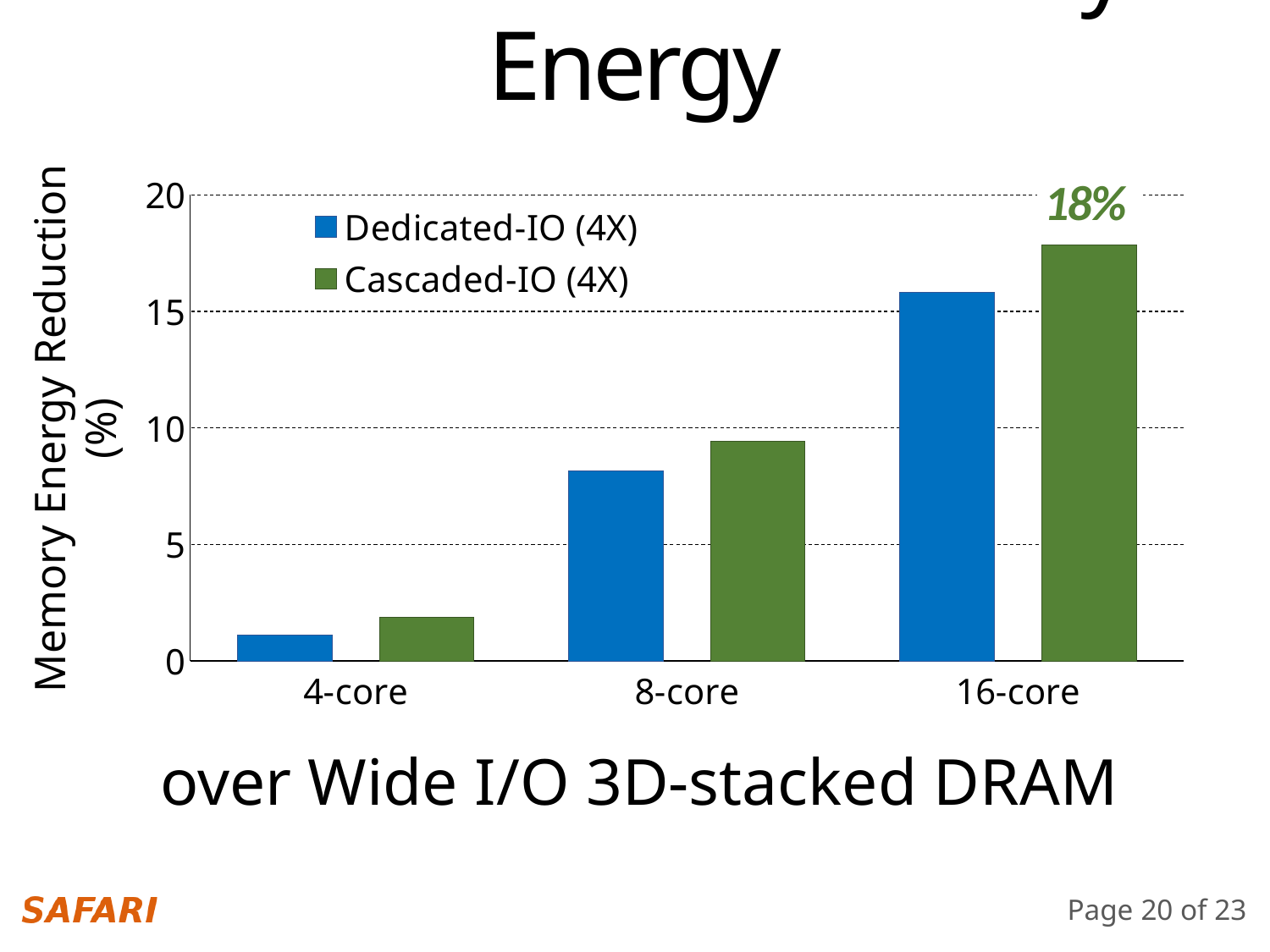
Is the Cascaded-IO (4X) value at 8-core greater or less than 10? less How many series does the legend list? 2 Do the Cascaded-IO (4X) values rise or fall as the core count increases from 4-core to 16-core? rise How many core-count categories are shown on the x axis? 3 Is the Dedicated-IO (4X) value at 16-core greater or less than 15? greater For which core count is the Cascaded-IO (4X) memory energy reduction highest? 16-core What kind of chart is shown on the slide? bar chart What is the Memory Energy Reduction for Cascaded-IO (4X) at 16-core? 18% At 8-core, which series has the larger memory energy reduction, Dedicated-IO (4X) or Cascaded-IO (4X)? Cascaded-IO (4X) What is the label of the y axis? Memory Energy Reduction (%) Is the Dedicated-IO (4X) value at 8-core greater or less than 5? greater For which core count is the Dedicated-IO (4X) memory energy reduction lowest? 4-core